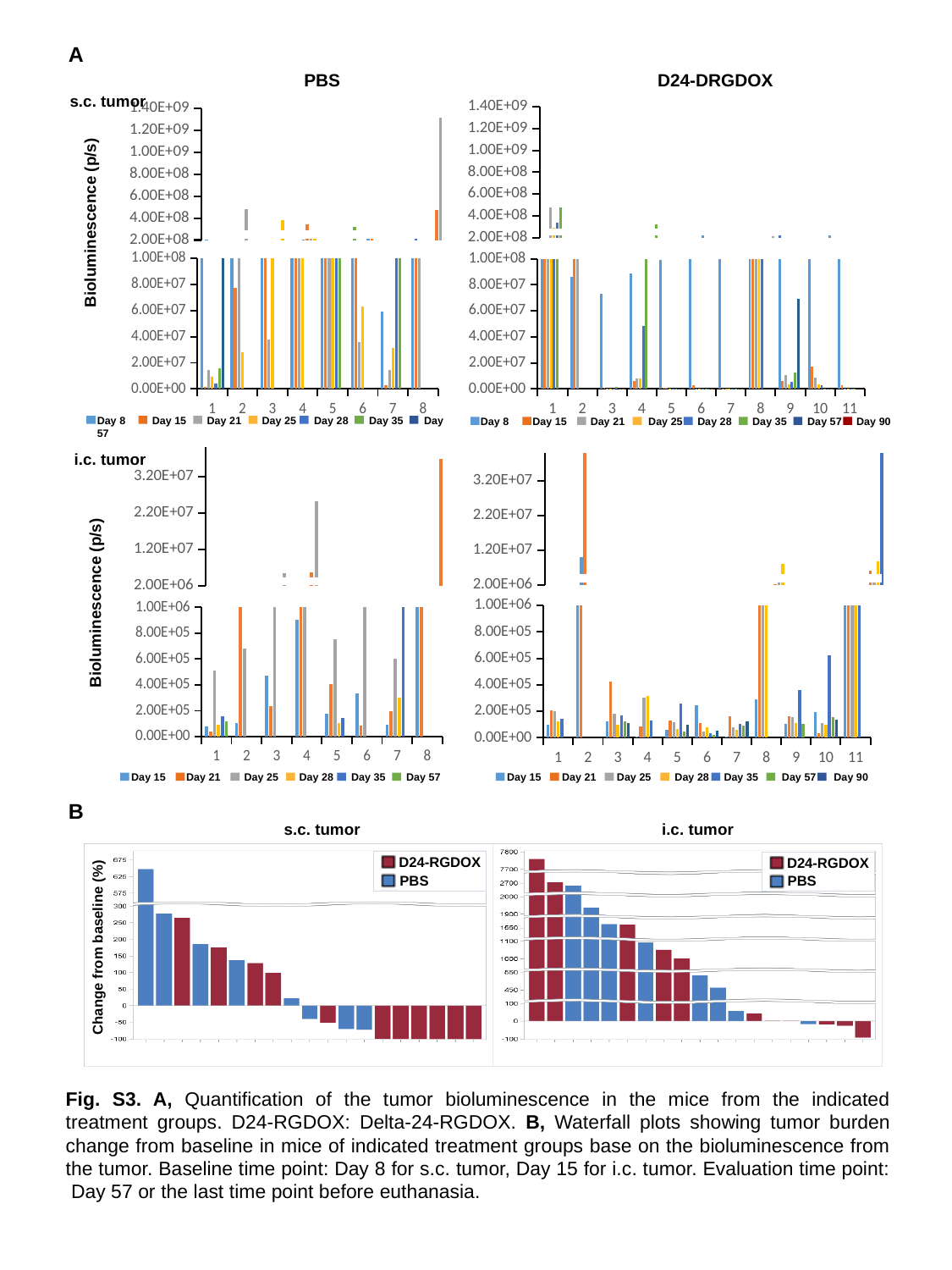
How many series does the legend of the D24-DRGDOX i.c. tumor chart in panel A list? 7 In the PBS s.c. tumor chart in panel A, is the Day 21 value for mouse 8 greater or less than 1.20E+09? greater What are the two legend entries in the i.c. tumor waterfall plot in panel B? D24-RGDOX and PBS In the PBS i.c. tumor chart in panel A, is the Day 25 value for mouse 4 greater or less than 1.20E+07? greater In the D24-DRGDOX s.c. tumor chart in panel A, how many mice are numbered along the x axis? 11 What kind of chart is the PBS s.c. tumor chart in panel A? bar chart How many series does the legend of the PBS s.c. tumor chart in panel A list? 7 How many series does the legend of the PBS i.c. tumor chart in panel A list? 6 What is the y-axis label of the charts in panel A? Bioluminescence (p/s) In the PBS s.c. tumor chart in panel A, how many mice are numbered along the x axis? 8